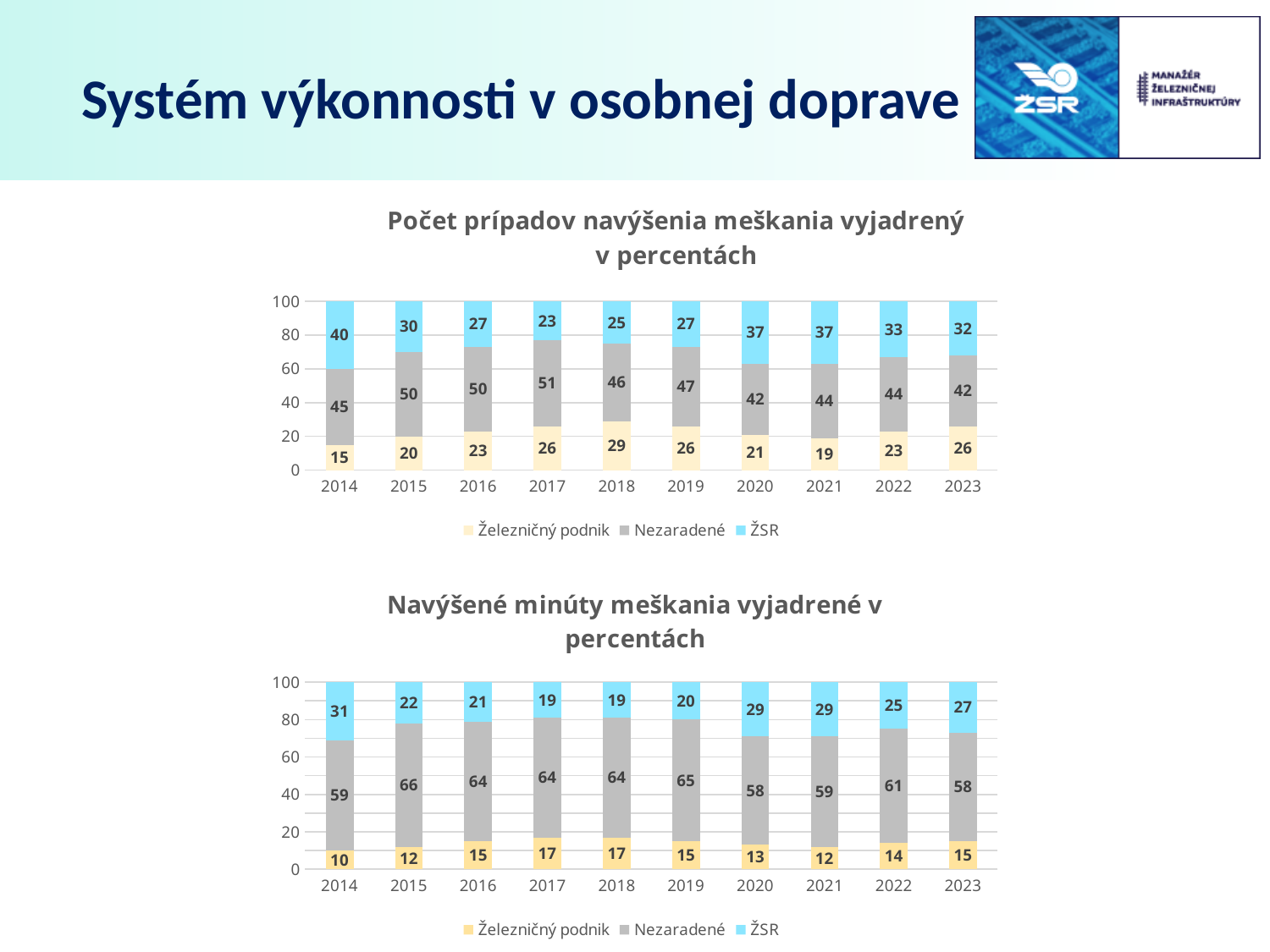
In the top chart (Počet prípadov navýšenia meškania vyjadrený v percentách), what is the value for Železničný podnik in 2018? 29 How many series does the legend of the bottom chart (Navýšené minúty meškania vyjadrené v percentách) list? 3 In the bottom chart (Navýšené minúty meškania vyjadrené v percentách), what is the value for Nezaradené in 2015? 66 In the top chart (Počet prípadov navýšenia meškania vyjadrený v percentách), what is the difference between the ŽSR values for 2014 and 2015? 10 In the bottom chart (Navýšené minúty meškania vyjadrené v percentách), which year has the lowest value for Železničný podnik? 2014 In the bottom chart (Navýšené minúty meškania vyjadrené v percentách), is the ŽSR value for 2014 larger or smaller than the ŽSR value for 2023? larger In the top chart (Počet prípadov navýšenia meškania vyjadrený v percentách), what is the total of the stacked bar for 2020? 100 In the top chart (Počet prípadov navýšenia meškania vyjadrený v percentách), which year has the lowest value for ŽSR? 2017 In the top chart (Počet prípadov navýšenia meškania vyjadrený v percentách), which year has the highest value for Nezaradené? 2017 In the bottom chart (Navýšené minúty meškania vyjadrené v percentách), how many years are shown on the x axis? 10 What type of chart is the top chart (Počet prípadov navýšenia meškania vyjadrený v percentách)? Stacked bar chart In the top chart (Počet prípadov navýšenia meškania vyjadrený v percentách), what is the value for ŽSR in 2014? 40